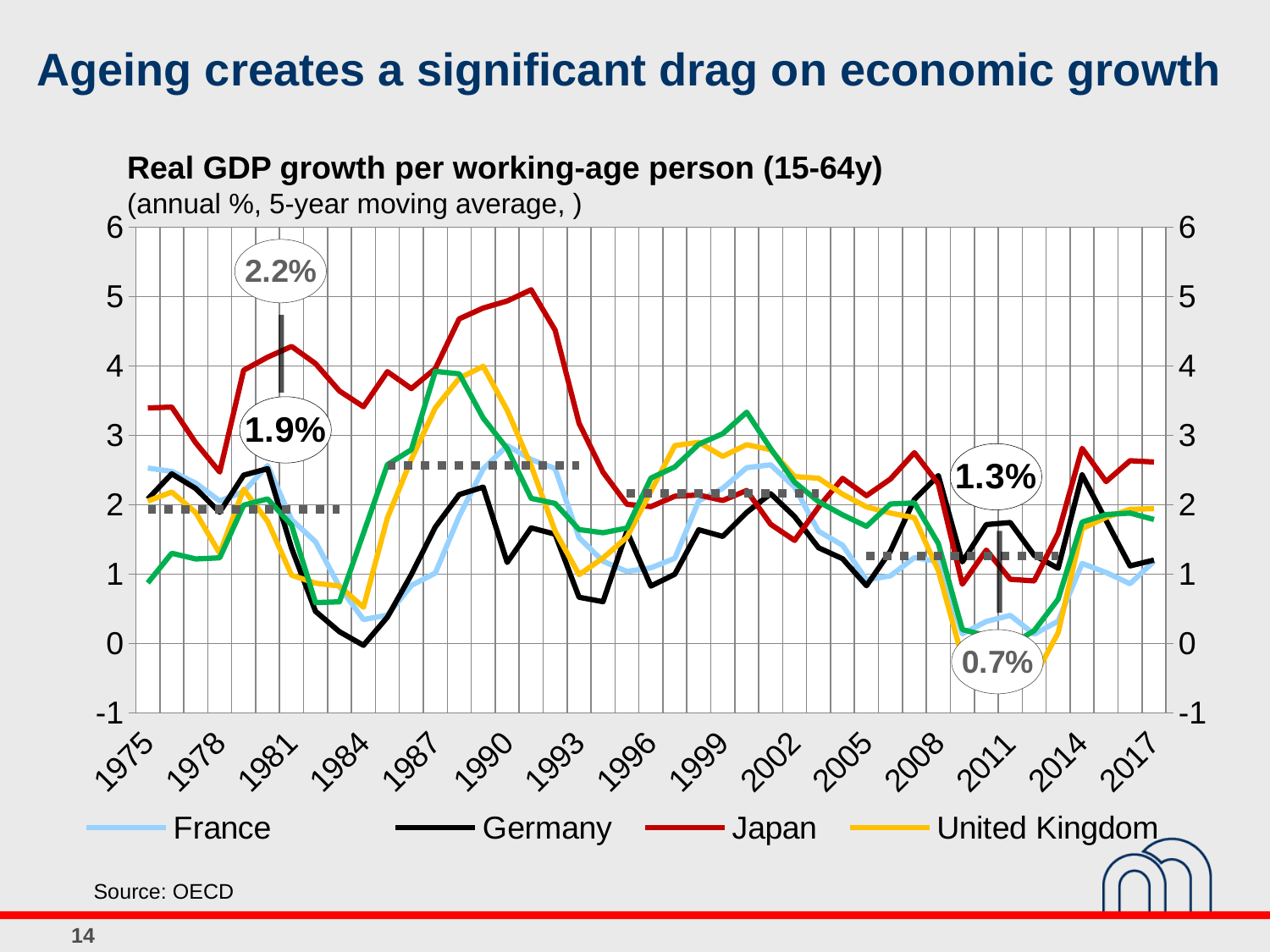
Which series has the highest value around 1990? Japan Is the value for Germany in 1984 greater or less than 1? less How many series does the legend list? 4 What is the title of the chart? Real GDP growth per working-age person (15-64y) Is the value for France in 2011 greater or less than 1? less Does the Japan line rise or fall between 1991 and 1995? fall What kind of chart is shown on the slide? line chart Is the value for Japan in 2017 greater or less than 2? greater In 1984, which is larger, the value for Japan or the value for Germany? Japan What value is shown in the annotation circle near 2011 at the bottom of the chart? 0.7% What source is cited for the chart? OECD